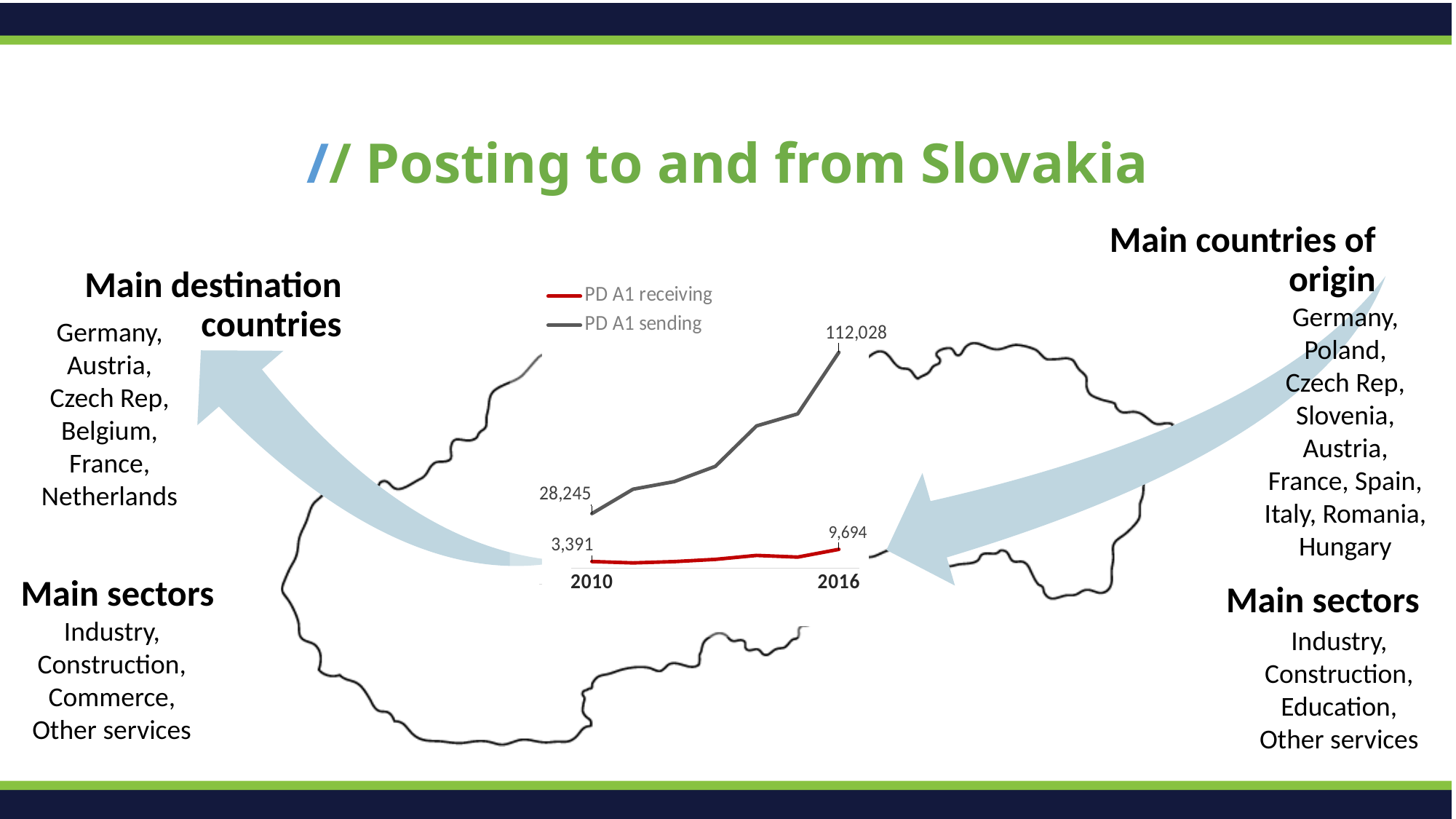
How many series does the chart legend list? 2 What is the value of PD A1 receiving in 2016? 9,694 What is the value of PD A1 sending in 2016? 112,028 What is the difference between PD A1 sending and PD A1 receiving in 2010? 24,854 By how much did PD A1 sending increase from 2010 to 2016? 83,783 By how much did PD A1 receiving increase from 2010 to 2016? 6,303 Does the PD A1 sending series rise or fall from 2010 to 2016? Rise In 2016, which series has the larger value, PD A1 sending or PD A1 receiving? PD A1 sending What colour is the PD A1 receiving line? Red What is the value of PD A1 sending in 2010? 28,245 What kind of chart is shown on the slide? Line chart What is the value of PD A1 receiving in 2010? 3,391